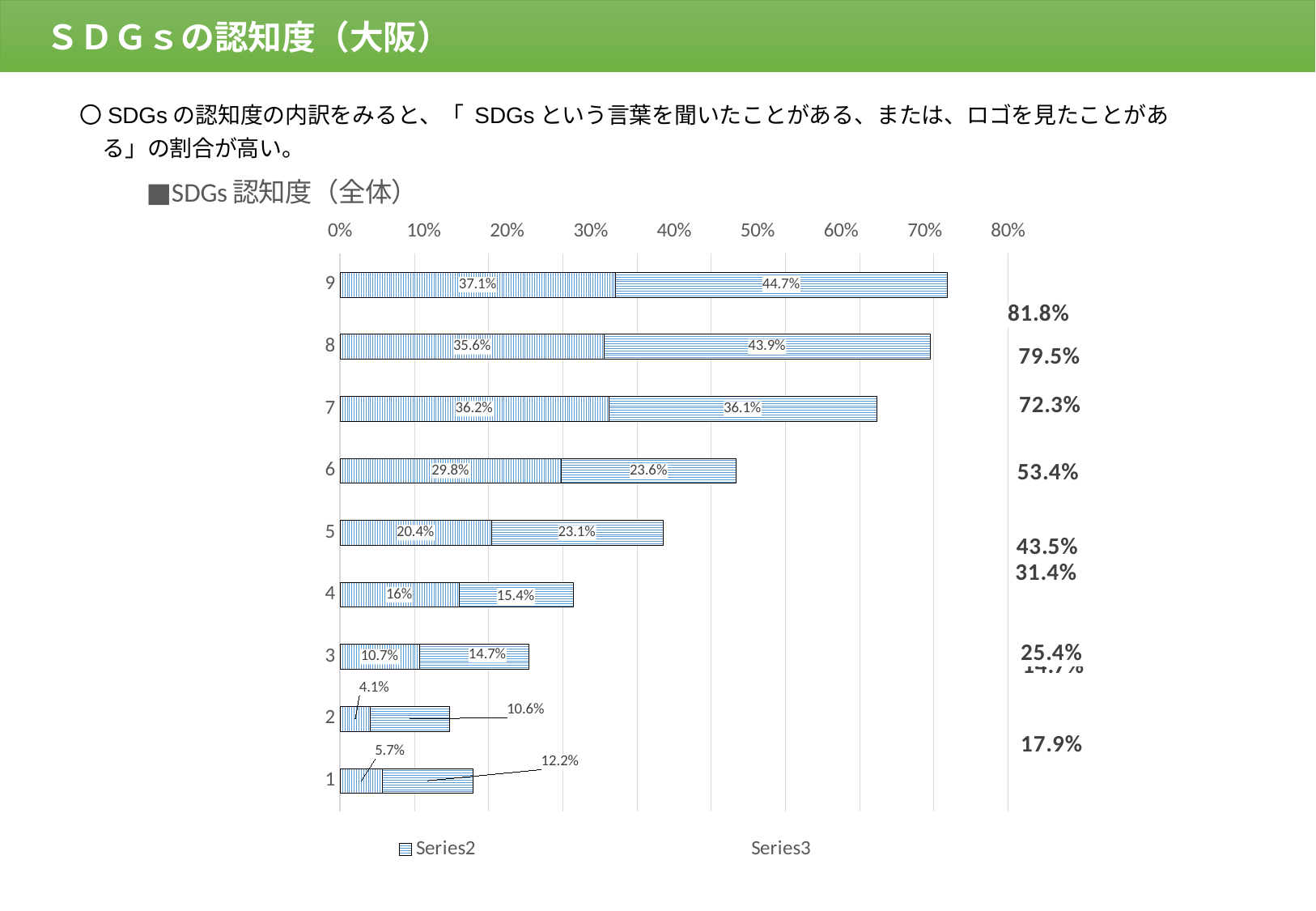
What is the Series2 value for category 9? 37.1% How many categories are plotted on the y axis? 9 What is the Series3 value for category 2? 10.6% For category 9, how much larger is the Series3 value than the Series2 value? 7.6% For category 5, which is larger, the Series2 value or the Series3 value? Series3 What kind of chart is shown on the slide? bar chart How many series does the legend list? 2 What is the total of the stacked bar for category 7? 72.3% What is the Series3 value for category 6? 23.6% Is the total length of the stacked bar for category 8 greater or less than 70%? greater Which category has the highest Series3 value? 9 Which category has the lowest Series2 value? 2